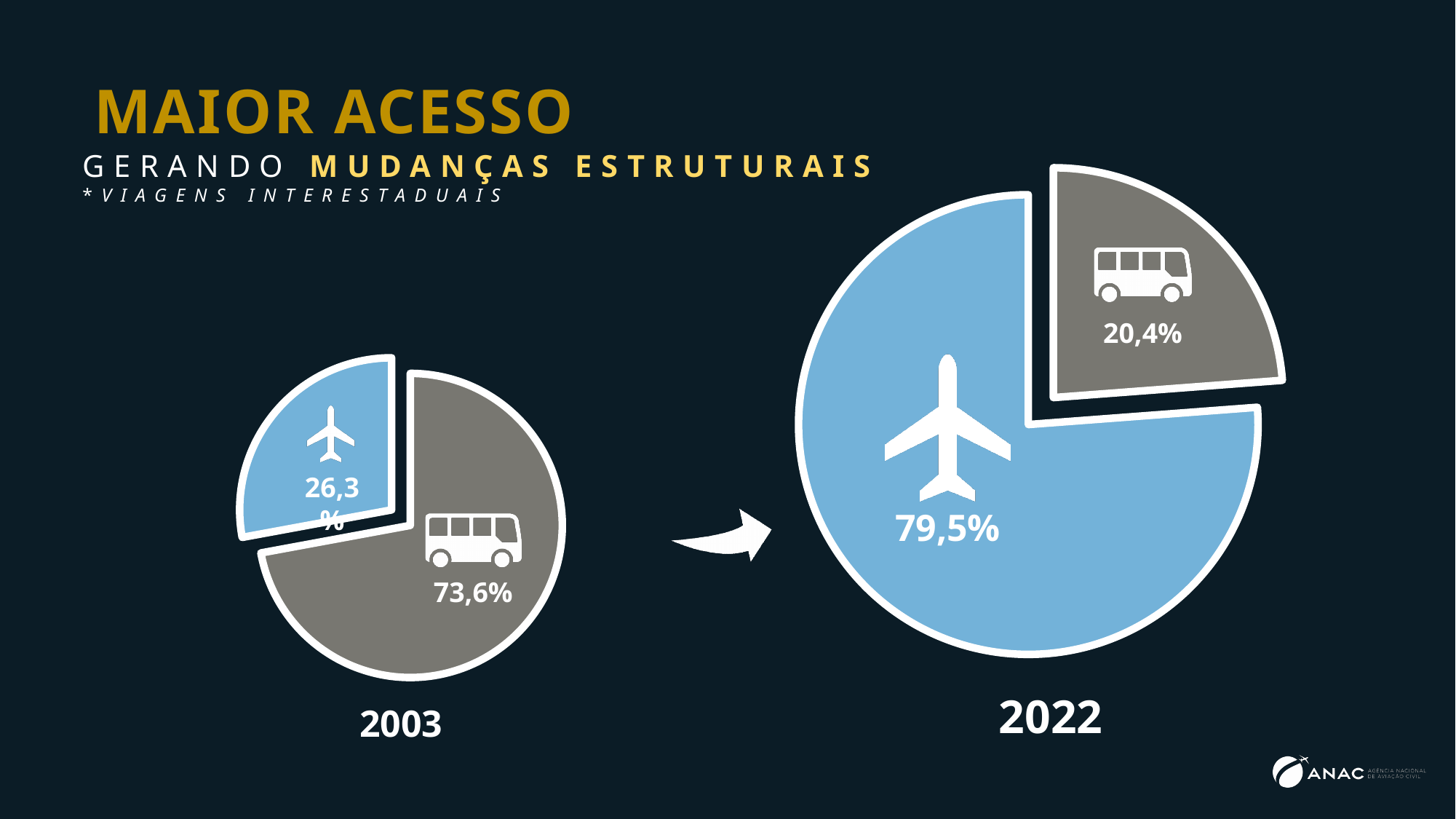
In the 2003 pie chart, which slice is the largest? Bus In the 2022 pie chart, which slice is larger, the airplane or the bus? Airplane What is the difference between the airplane share in 2022 and the airplane share in 2003? 53,2 percentage points In the 2022 pie chart, what share is shown for the airplane slice? 79,5% In the 2003 pie chart, what is the difference between the bus share and the airplane share? 47,3 percentage points How many slices does the 2022 pie chart have? 2 What kind of chart is used for the 2003 and 2022 data? Pie chart In the 2022 pie chart, which slice is the smallest? Bus In the 2003 pie chart, what share is shown for the airplane slice? 26,3% In the 2022 pie chart, what share is shown for the bus slice? 20,4% In the 2003 pie chart, what share is shown for the bus slice? 73,6% What colour is the airplane slice in both pie charts? Light blue